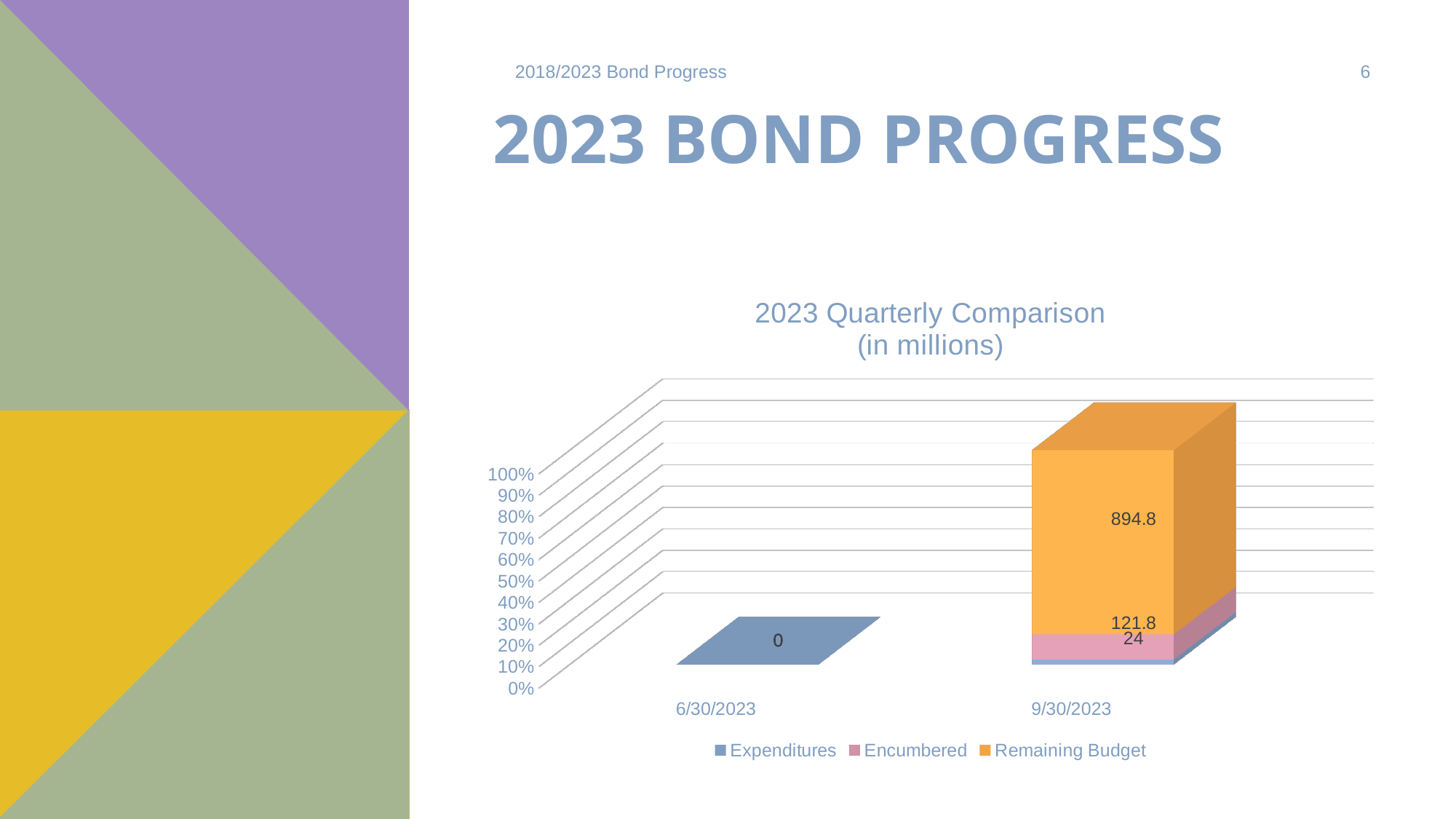
What is the difference between the Remaining Budget and Encumbered values for 9/30/2023? 773 What value is labelled on the bar for 6/30/2023? 0 How many series does the legend list? 3 Which series has the largest value for 9/30/2023? Remaining Budget How many dates are shown on the x axis? 2 What is the title of the chart? 2023 Quarterly Comparison (in millions) What is the Expenditures value for 9/30/2023? 24 What is the Encumbered value for 9/30/2023? 121.8 What is the Remaining Budget value for 9/30/2023? 894.8 What is the difference between the Encumbered and Expenditures values for 9/30/2023? 97.8 What is the total of the stacked bar for 9/30/2023? 1040.6 Which series has the smallest value for 9/30/2023? Expenditures